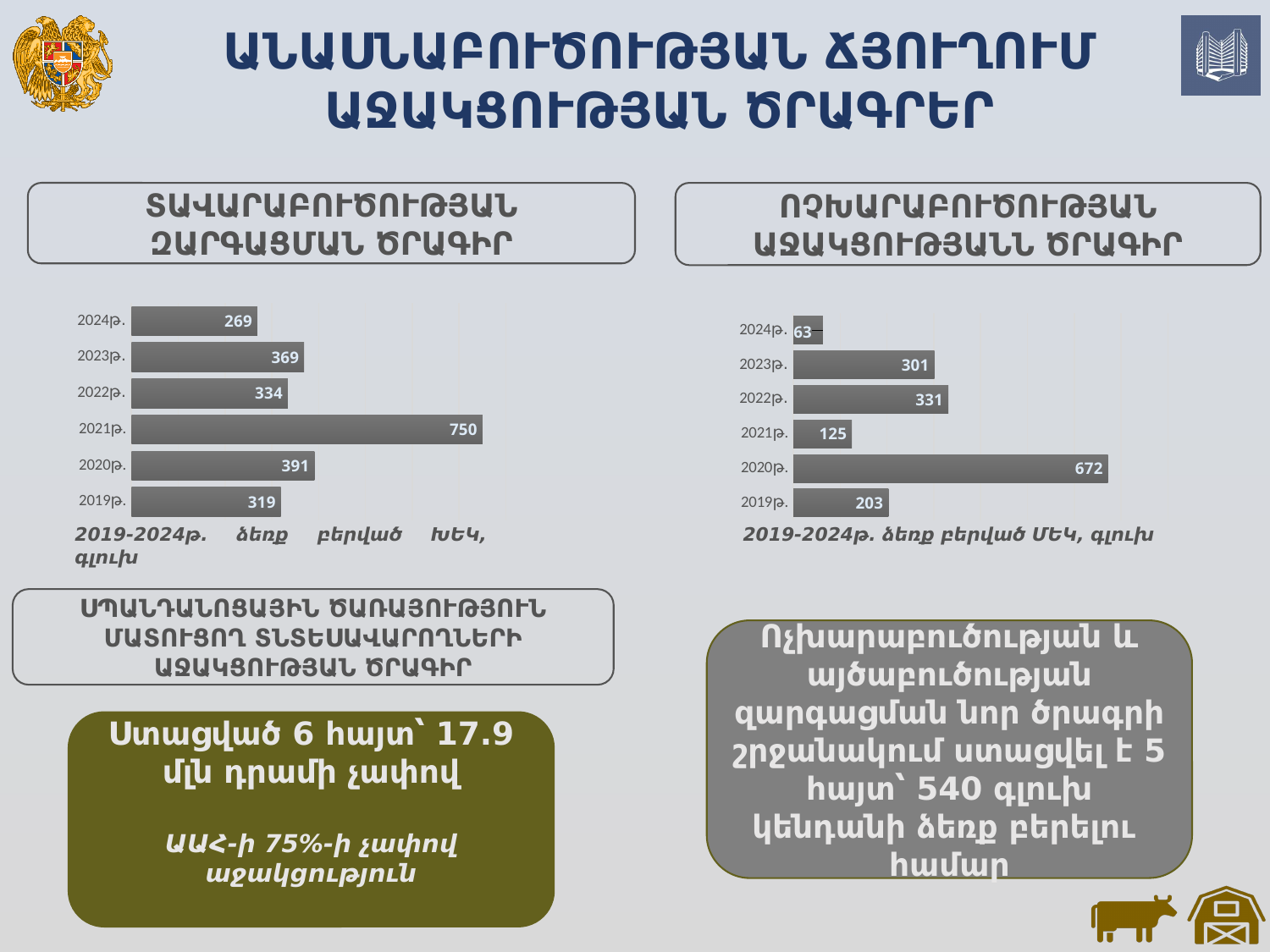
In the right chart (ՈՉԽԱՐԱԲՈՒԾՈՒԹՅԱՆ ԱՋԱԿՑՈՒԹՅԱՆՆ ԾՐԱԳԻՐ), what is the value for 2020թ.? 672 In the right chart, what is the difference between the values for 2020թ. and 2021թ.? 547 In the right chart, which year has the lowest value? 2024թ. In the left chart (ՏԱՎԱՐԱԲՈՒԾՈՒԹՅԱՆ ԶԱՐԳԱՑՄԱՆ ԾՐԱԳԻՐ), what is the value for 2021թ.? 750 In the left chart, which year has the lowest value? 2024թ. In the left chart, which year has the highest value? 2021թ. In the left chart, what is the value for 2024թ.? 269 In the right chart, which is larger, the value for 2022թ. or the value for 2023թ.? 2022թ. In the left chart, how many years are shown? 6 What type of chart is the right chart? Bar chart In the left chart, what is the difference between the values for 2023թ. and 2022թ.? 35 In the right chart, what is the value for 2019թ.? 203